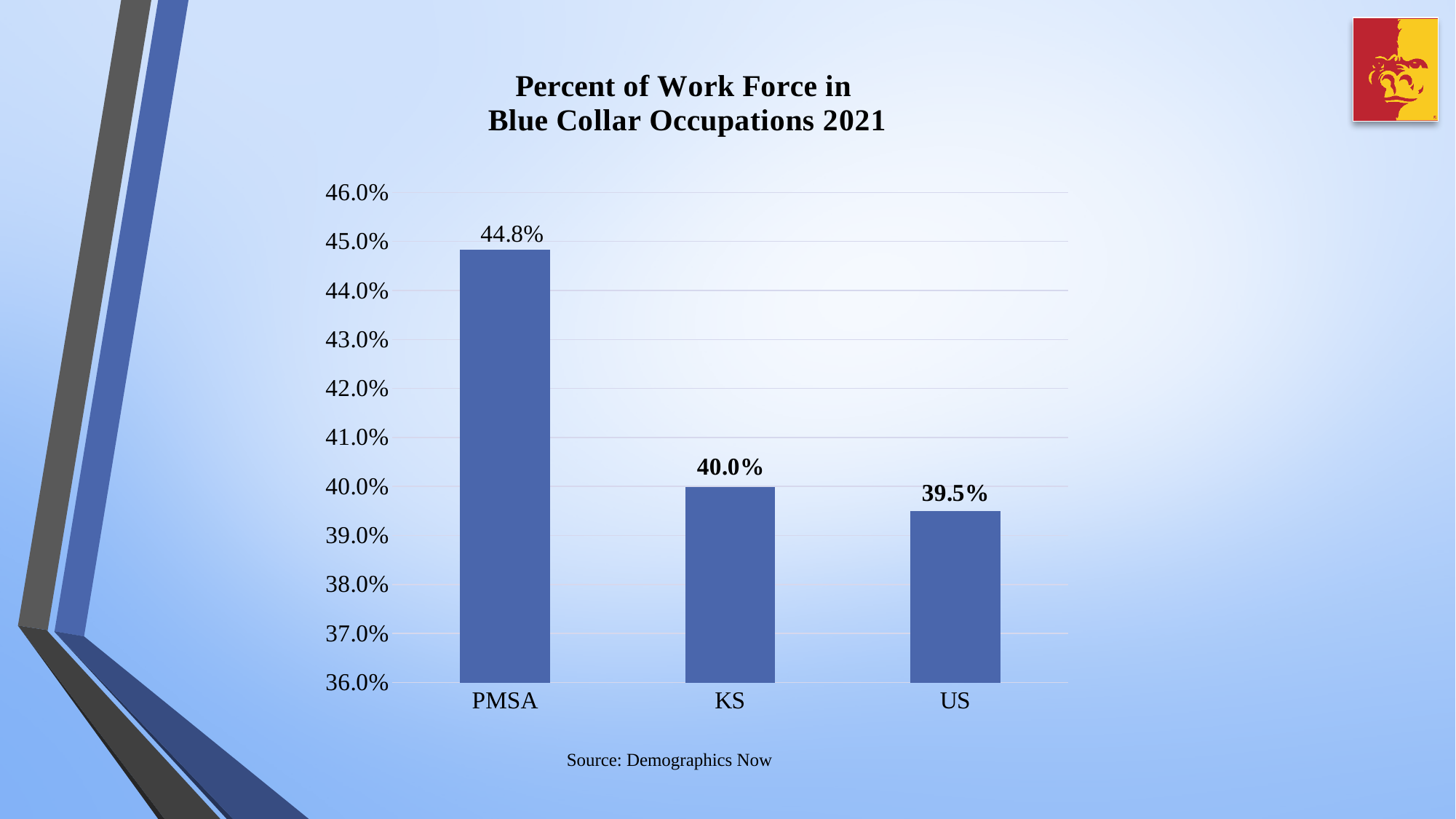
What is the value for PMSA? 44.8% What is the title of the chart? Percent of Work Force in Blue Collar Occupations 2021 What is the value for KS? 40.0% What is the difference between the values for PMSA and US? 5.3% What is the difference between the values for KS and US? 0.5% What is the value for US? 39.5% What kind of chart is shown on the slide? bar chart Which is larger, the value for PMSA or the value for KS? PMSA How many categories are shown on the chart? 3 Which category has the highest percent of work force in blue collar occupations? PMSA Is the value for US greater or less than 40.0%? less Which category has the lowest percent of work force in blue collar occupations? US